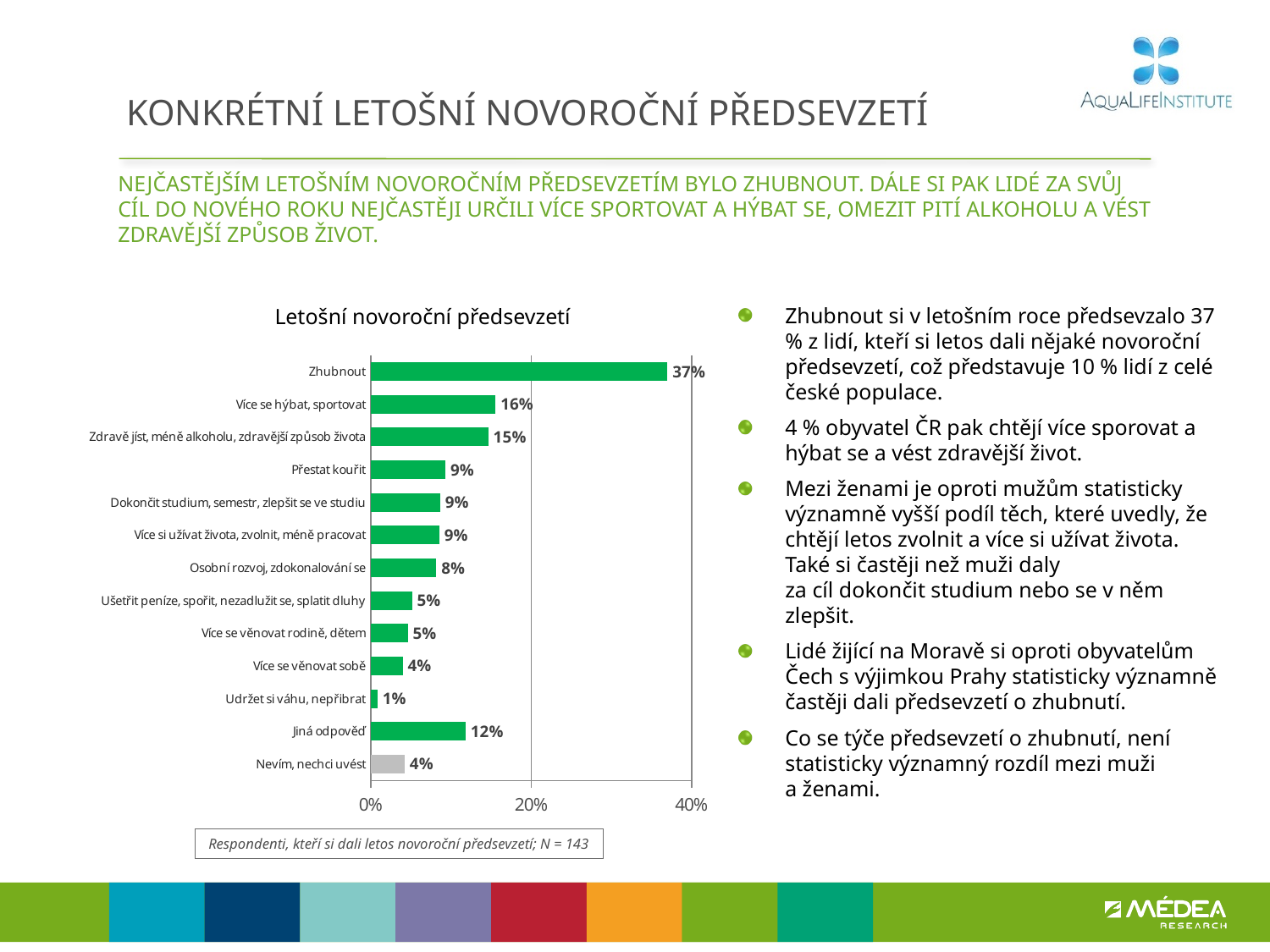
Which is larger: the value for "Přestat kouřit" or the value for "Osobní rozvoj, zdokonalování se"? Přestat kouřit How many categories are shown in the chart? 13 Is the value for "Zhubnout" greater or less than 20%? greater What type of chart is shown on the slide? bar chart What is the title of the chart? Letošní novoroční předsevzetí What is the value for "Zhubnout" in the chart? 37% What is the difference between the values for "Zhubnout" and "Více se hýbat, sportovat"? 21% What is the value for "Udržet si váhu, nepřibrat"? 1% Which category has the lowest value in the chart? Udržet si váhu, nepřibrat What is the value for "Jiná odpověď"? 12% Which category has the highest value in the chart? Zhubnout What is the value for "Více se hýbat, sportovat"? 16%